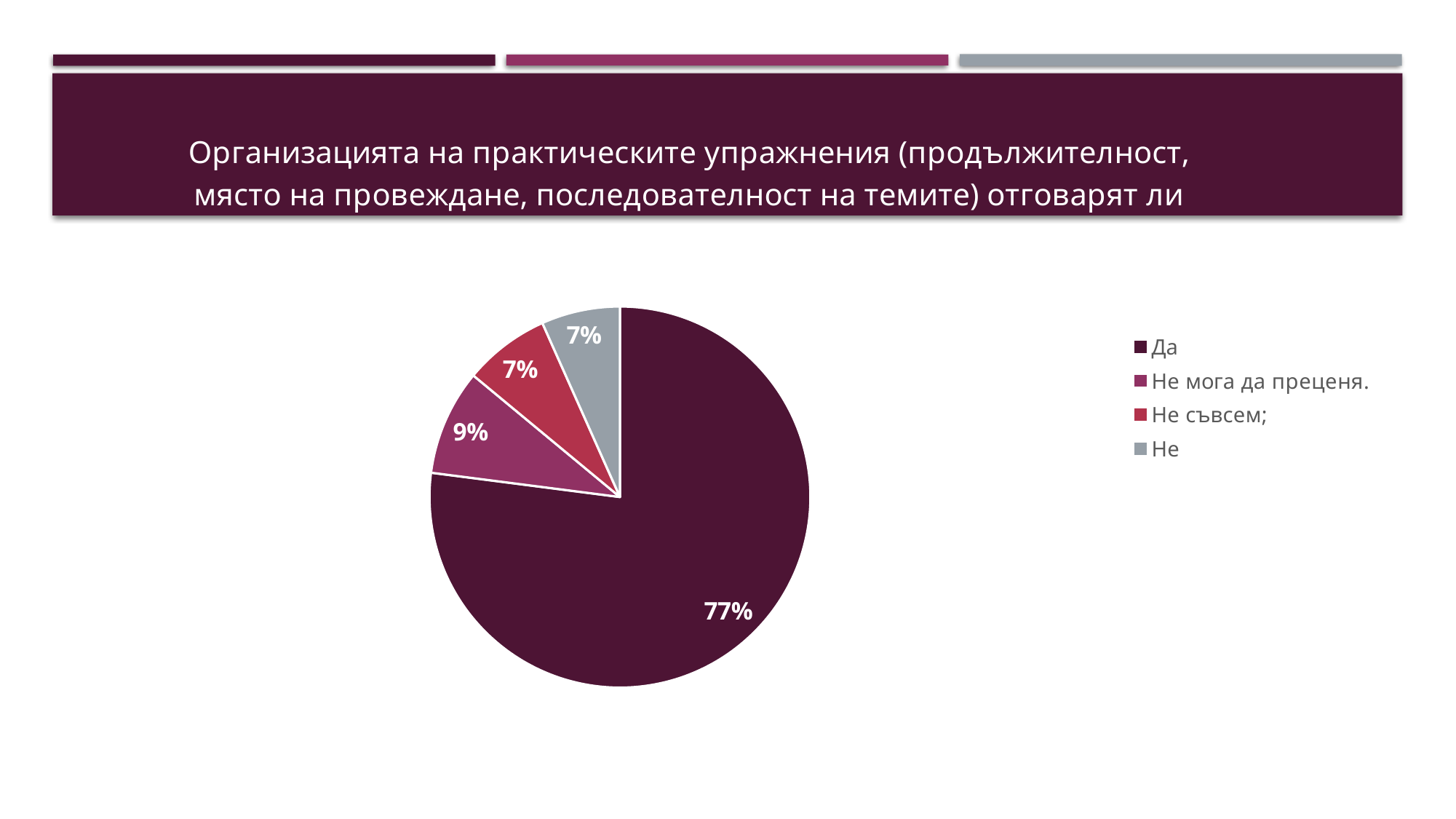
What is the difference between the share for "Да" and the share for "Не мога да преценя."? 68% What share of the pie does "Не мога да преценя." have? 9% What share of the pie does "Не" have? 7% What share of the pie does "Да" have? 77% How many entries does the legend list? 4 What is the combined share of "Не съвсем;" and "Не"? 14% How many slices does the pie chart have? 4 Which category has the largest slice of the pie? Да What colour is the slice for "Не"? grey Which is larger, the share for "Не мога да преценя." or the share for "Не"? Не мога да преценя. What kind of chart is shown on the slide? pie chart